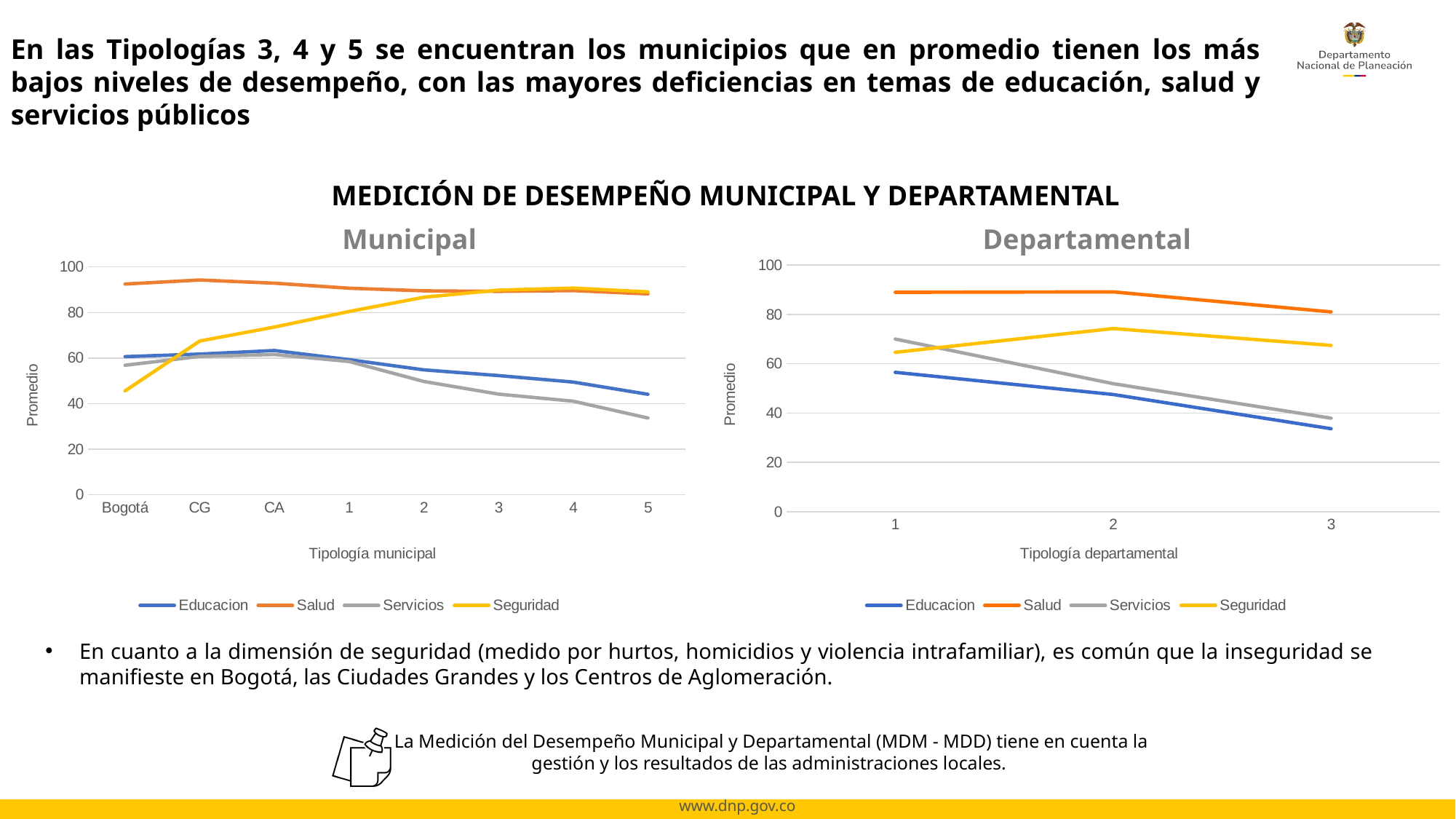
In the Municipal chart, does the Seguridad series rise or fall from Bogotá to 4? rise In the Municipal chart, which series has the lowest value for Bogotá? Seguridad What kind of chart is the Municipal chart? line chart In the Municipal chart, is the value of Salud for CG greater or less than 80? greater In the Municipal chart, is the value of Seguridad for Bogotá greater or less than 60? less In the Municipal chart, does the Servicios series rise or fall from Bogotá to 5? fall How many series does the legend of the Departamental chart list? 4 In the Departamental chart, which is larger for tipología 1: Servicios or Educacion? Servicios In the Departamental chart, is the value of Servicios for tipología 3 greater or less than 40? less In the Departamental chart, which series has the highest value for tipología 3? Salud How many categories are shown on the x axis of the Municipal chart? 8 What is the x-axis title of the Departamental chart? Tipología departamental